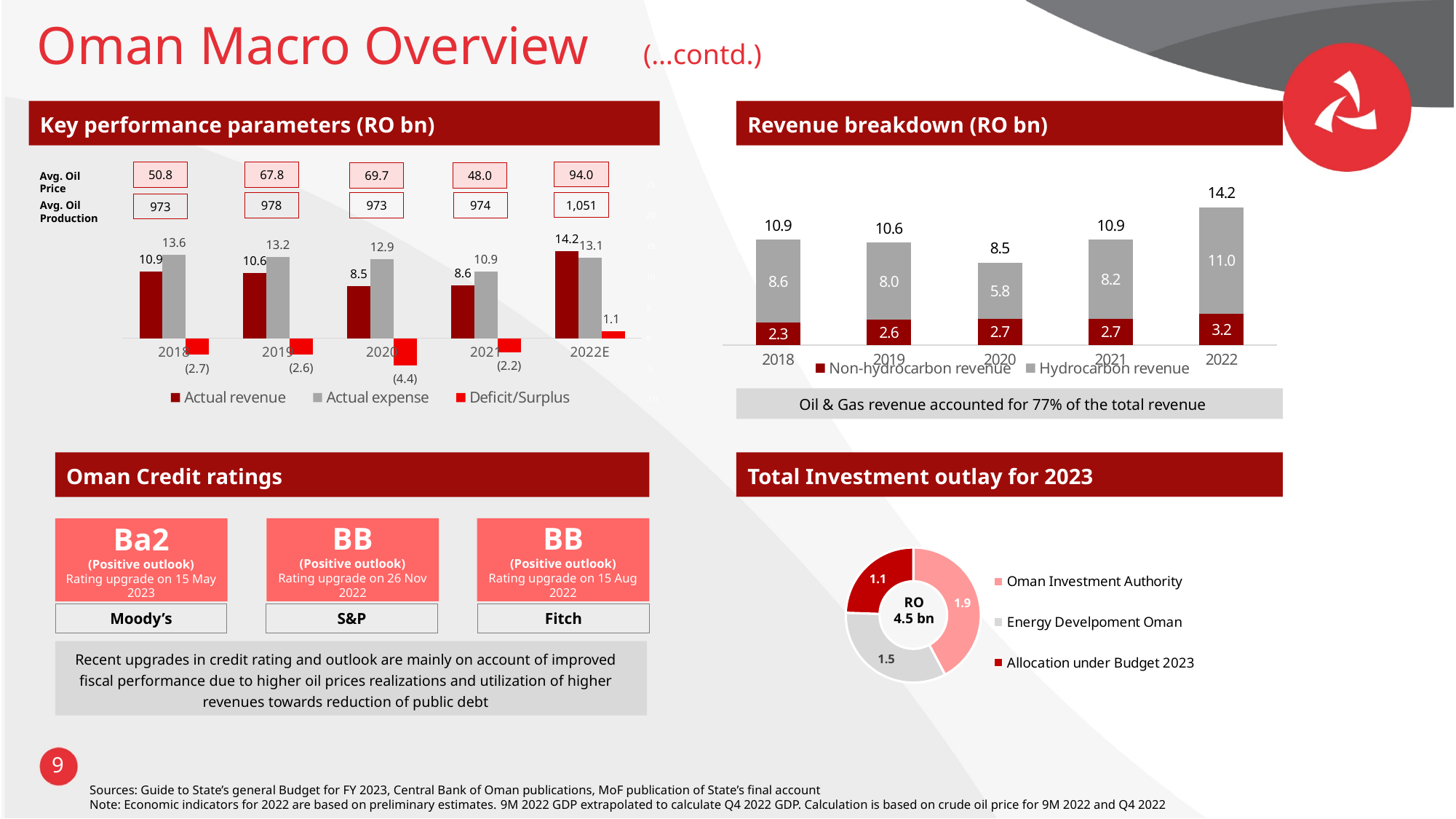
In the Revenue breakdown chart, which year has the highest total revenue? 2022 In the Revenue breakdown chart, what is the total revenue for 2020? 8.5 In the Key performance parameters chart, which year has the lowest Actual revenue? 2020 In the Key performance parameters chart, what is the Deficit/Surplus value for 2020? (4.4) In the Revenue breakdown chart, what is the Hydrocarbon revenue for 2022? 11.0 In the Revenue breakdown chart, what is the Non-hydrocarbon revenue for 2019? 2.6 In the Key performance parameters chart, what is the Actual expense for 2020? 12.9 In the Revenue breakdown chart, what is the difference between Hydrocarbon revenue in 2022 and 2021? 2.8 In the Key performance parameters chart, how many series does the legend list? 3 In the Total Investment outlay for 2023 chart, what is the value for Energy Development Oman? 1.5 In the Key performance parameters chart, what is the Actual revenue for 2022E? 14.2 What kind of chart is the Total Investment outlay for 2023 chart? Donut chart